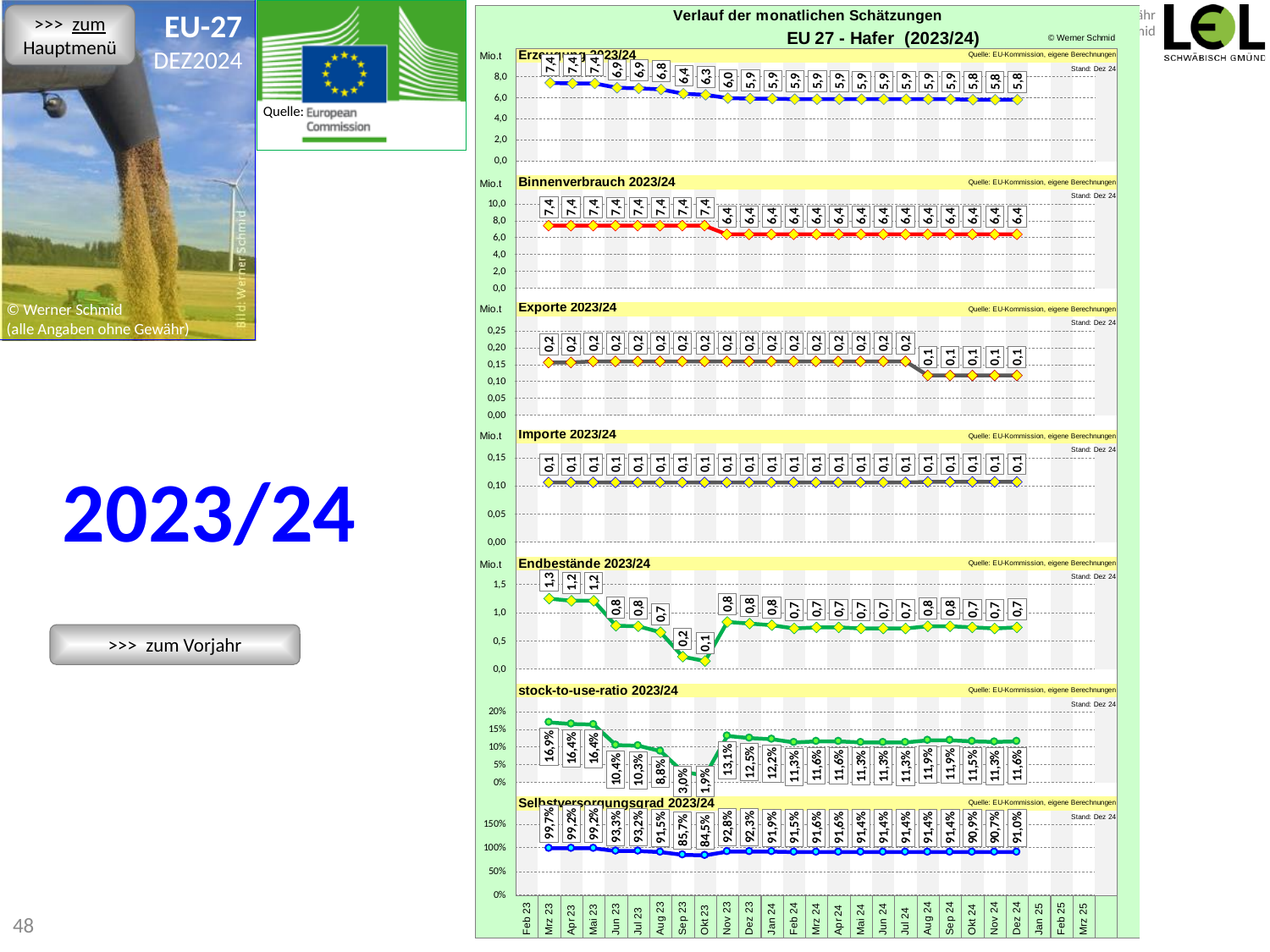
In the Binnenverbrauch 2023/24 chart, what is the value for Dez 24? 6,4 In the Erzeugung 2023/24 chart, what is the highest value shown? 7,4 In the Selbstversorgungsgrad 2023/24 chart, what is the value for Dez 24? 91,0% In the Erzeugung 2023/24 chart, do the values rise or fall from Mrz 23 to Dez 24? fall In the stock-to-use-ratio 2023/24 chart, which is larger, the value for Mrz 23 or the value for Dez 24? Mrz 23 In the Exporte 2023/24 chart, what is the value for Dez 24? 0,1 In the Erzeugung 2023/24 chart, what is the value for Dez 24? 5,8 In the Endbestände 2023/24 chart, what is the lowest value shown? 0,1 In the stock-to-use-ratio 2023/24 chart, what is the lowest value shown? 1,9% In the Binnenverbrauch 2023/24 chart, what is the difference between the value for Mrz 23 (7,4) and the value for Dez 24 (6,4)? 1,0 What kind of chart is the Erzeugung 2023/24 chart? line chart In the Importe 2023/24 chart, what is the value for Dez 24? 0,1